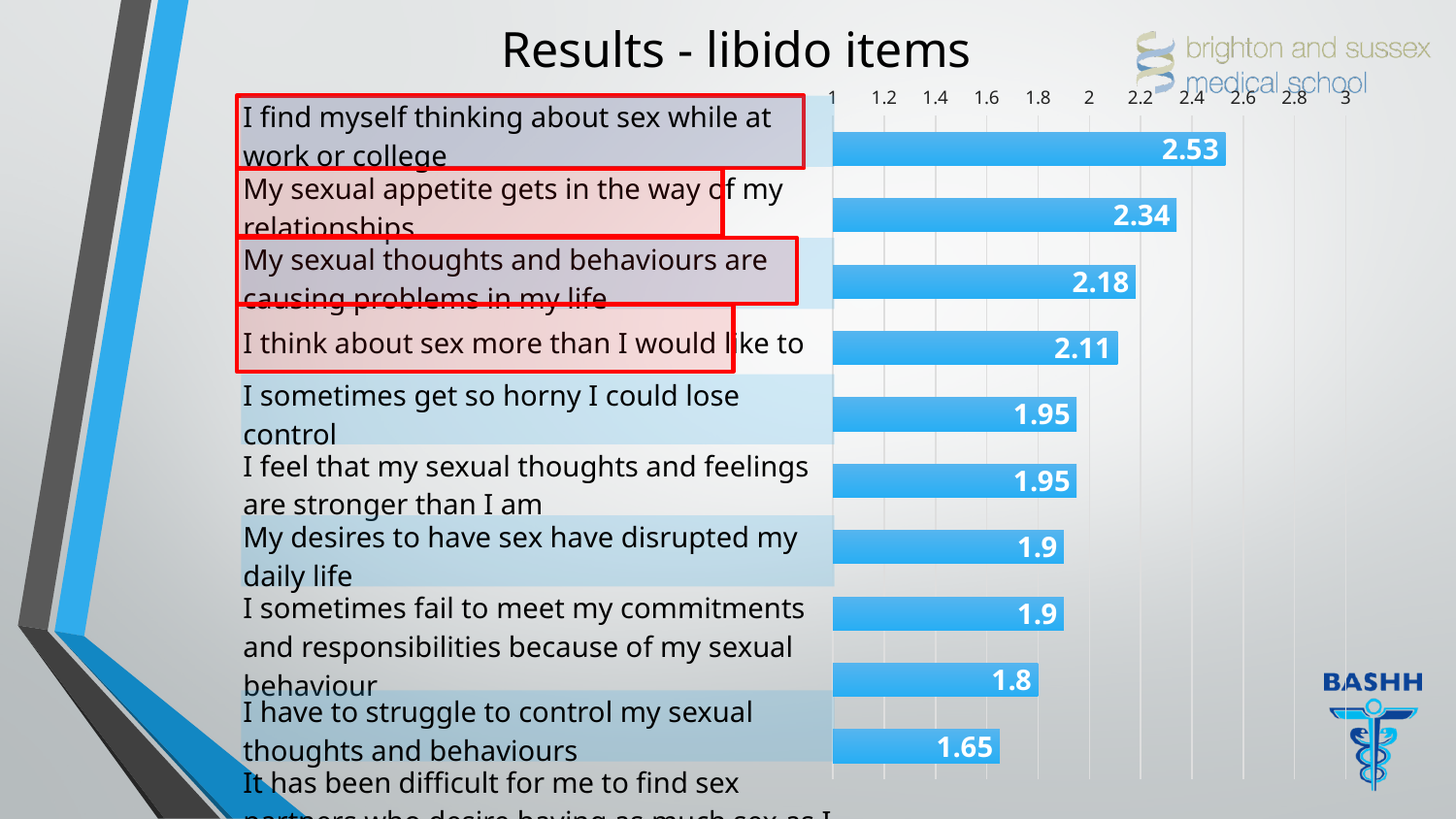
What is the value for "My desires to have sex have disrupted my daily life"? 1.9 What kind of chart is shown on the slide? bar chart Which is larger: the value for "My sexual appetite gets in the way of my relationships" or the value for "I think about sex more than I would like to"? My sexual appetite gets in the way of my relationships What is the value for "My sexual appetite gets in the way of my relationships"? 2.34 What is the value for "I think about sex more than I would like to"? 2.11 What is the lowest value shown on the chart? 1.65 What is the difference between the highest value (2.53) and the lowest value (1.65)? 0.88 Which item has the highest value? I find myself thinking about sex while at work or college What is the value for "My sexual thoughts and behaviours are causing problems in my life"? 2.18 How many bars are plotted on the chart? 10 What is the title of the slide? Results - libido items What is the value for "I find myself thinking about sex while at work or college"? 2.53